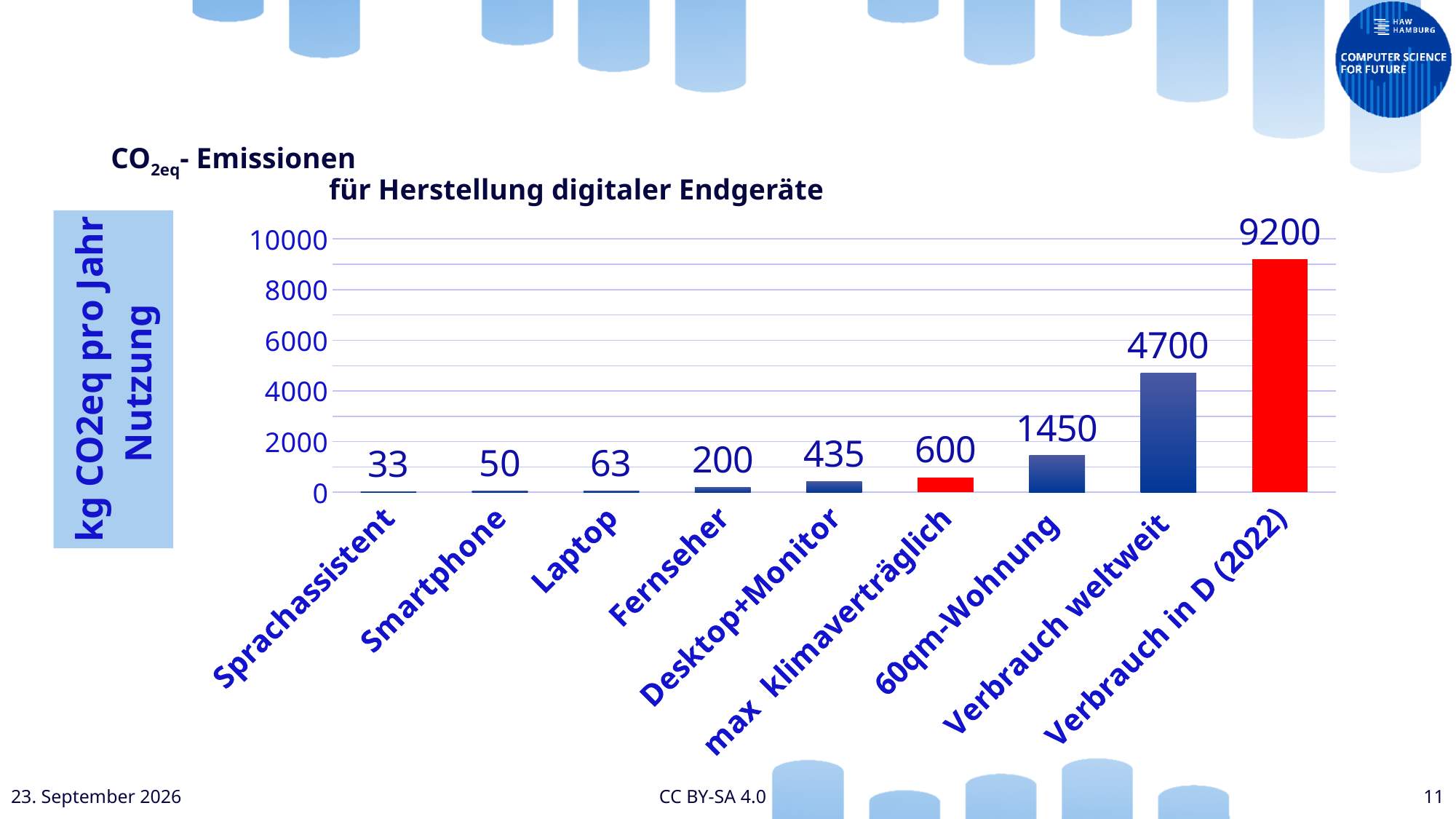
What is the difference between Verbrauch in D (2022) and Verbrauch weltweit? 4500 Which category has the highest value? Verbrauch in D (2022) What kind of chart is shown? bar chart What is the value for Laptop? 63 Which is larger, Fernseher or Smartphone? Fernseher How many categories are shown on the x axis? 9 Which category has the lowest value? Sprachassistent What is the y-axis label of the chart? kg CO2eq pro Jahr Nutzung What is the value for 60qm-Wohnung? 1450 What is the difference between max klimaverträglich and Desktop+Monitor? 165 Is the value for Verbrauch in D (2022) greater or less than 8000? greater What is the value for Verbrauch weltweit? 4700